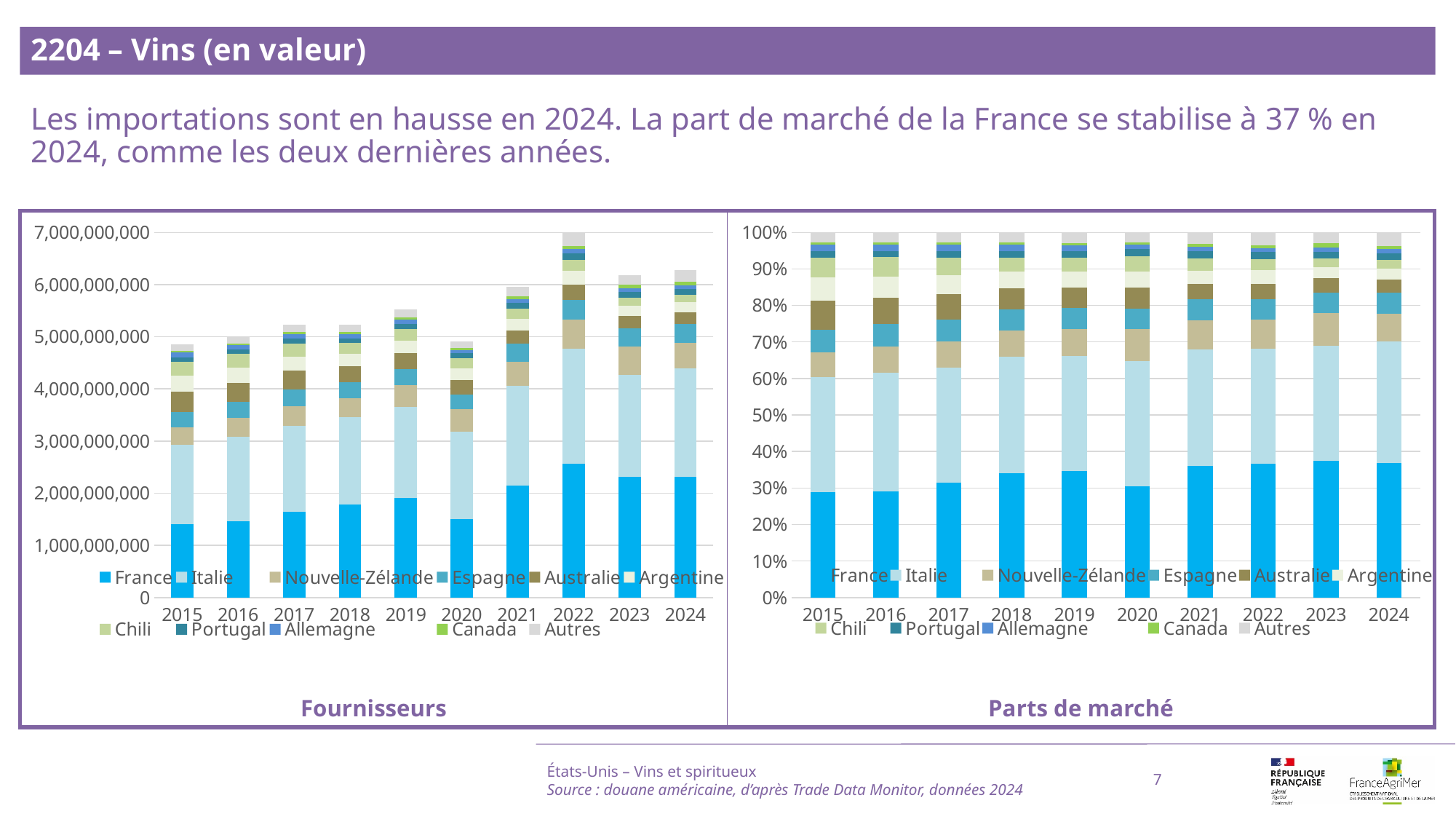
In the 'Fournisseurs' chart, is the value for France in 2015 greater or less than 2,000,000,000? less In the 'Fournisseurs' chart, which is larger: the value for France in 2022 or in 2015? 2022 In the 'Parts de marché' chart, is the share for France in 2023 greater or less than 40%? less How many years are shown on the x axis of the 'Parts de marché' chart? 10 In the 'Parts de marché' chart, is the share for France in 2024 greater or less than 30%? greater What kind of chart is the 'Fournisseurs' chart? stacked bar chart In the 'Fournisseurs' chart, which year has the highest total stacked bar? 2022 In the 'Parts de marché' chart, does the share for France rise or fall overall from 2015 to 2024? rise Which series is plotted at the bottom of each stacked bar in the 'Parts de marché' chart? France How many series does the legend of the 'Fournisseurs' chart list? 11